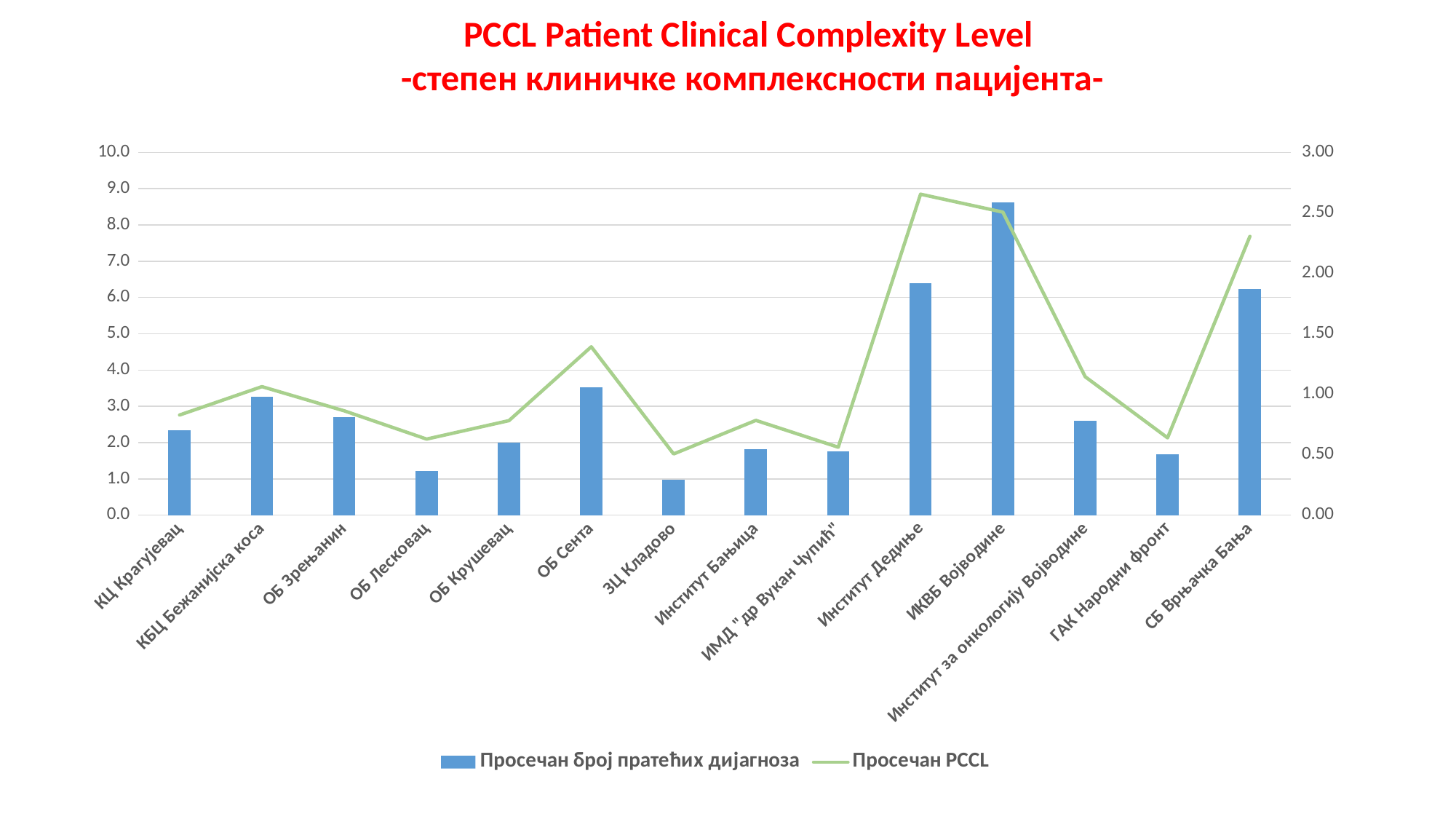
Is the Просечан PCCL value for Институт Дедиње greater or less than 2.50? greater How many series does the legend list? 2 Which institution has the highest point on the Просечан PCCL line? Институт Дедиње Is the Просечан број пратећих дијагноза bar for ИКВБ Војводине greater or less than 8.0? greater Which institution has the lowest bar for Просечан број пратећих дијагноза? ЗЦ Кладово What kind of chart is shown on the slide? A combined bar and line chart Which has the larger Просечан број пратећих дијагноза bar, КБЦ Бежанијска коса or КЦ Крагујевац? КБЦ Бежанијска коса Which series is drawn as a green line? Просечан PCCL How many institutions (categories) are shown on the x axis? 14 Which has the larger Просечан број пратећих дијагноза bar, ОБ Сента or ОБ Зрењанин? ОБ Сента Which institution has the highest bar for Просечан број пратећих дијагноза? ИКВБ Војводине